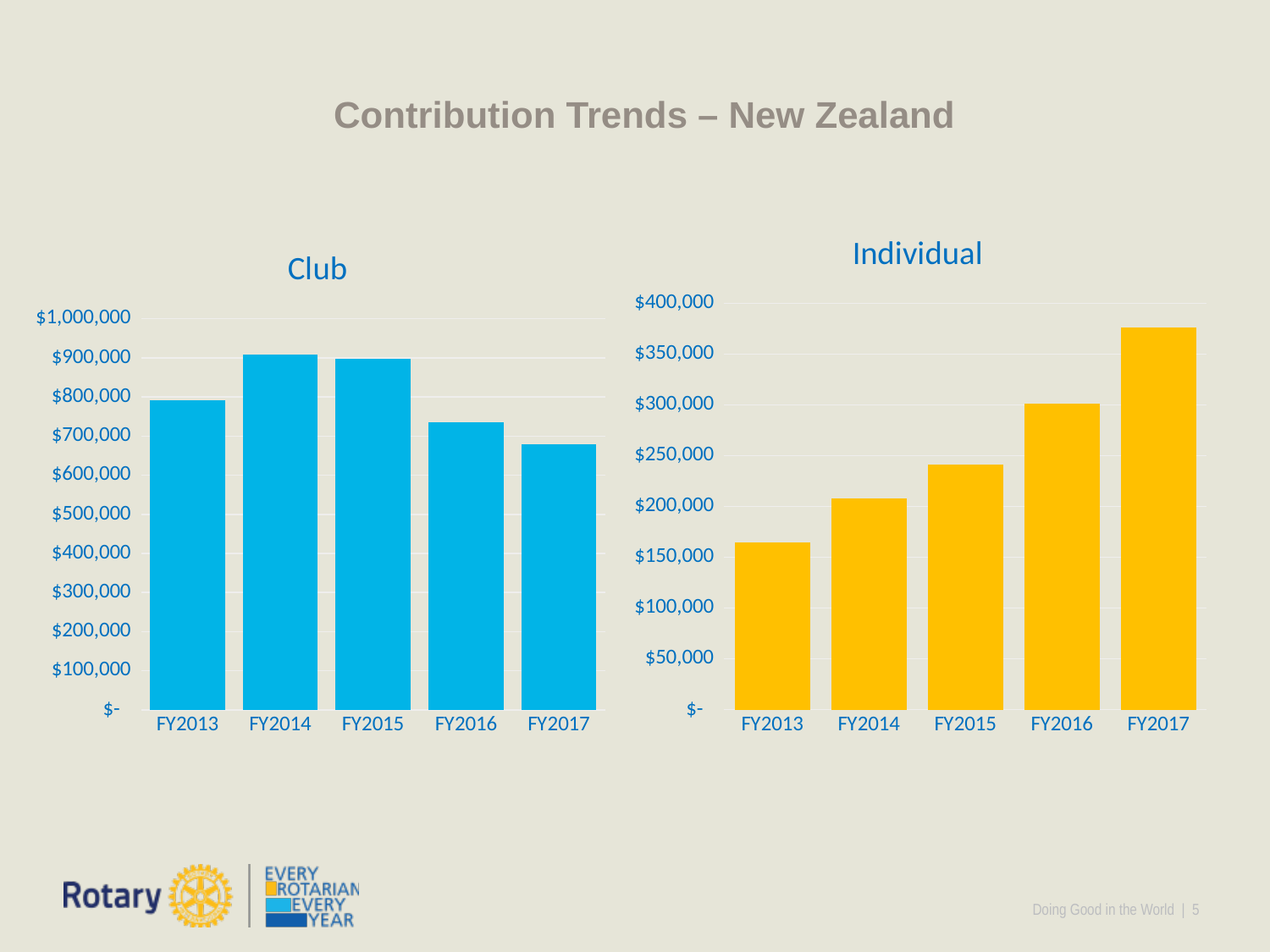
In the Individual chart, is the value for FY2013 greater or less than $200,000? less In the Individual chart, which is larger, the value for FY2014 or the value for FY2016? FY2016 In the Club chart, which is larger, the value for FY2013 or the value for FY2016? FY2013 In the Club chart, which fiscal year has the lowest contribution? FY2017 In the Individual chart, which fiscal year has the lowest contribution? FY2013 How many fiscal years are shown in the Club chart? 5 In the Individual chart, which fiscal year has the highest contribution? FY2017 In the Individual chart, is the value for FY2017 greater or less than $350,000? greater In the Club chart, is the value for FY2017 greater or less than $700,000? less In the Individual chart, do the values rise or fall from FY2013 to FY2017? rise What type of chart is the Individual chart? bar chart